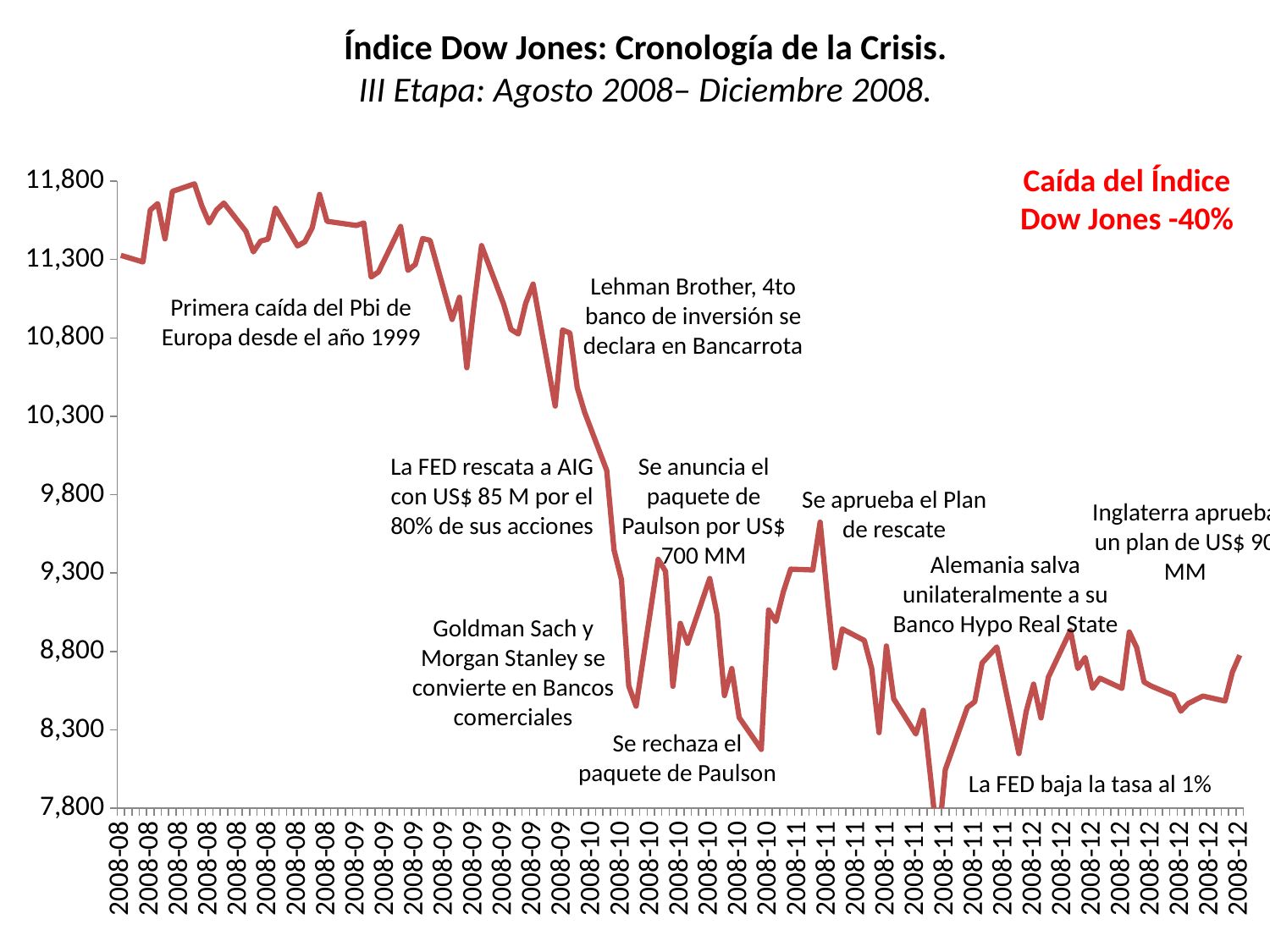
What kind of chart is shown on the slide? line chart In which month does the line reach its highest values? 2008-08 Is the value at the peak labelled 'Se aprueba el Plan de rescate' in 2008-11 greater or less than 9,300? greater Is the final value of the line in 2008-12 greater or less than 9,300? less Overall, do the values of the Dow Jones index rise or fall from 2008-08 to 2008-12? fall Is the final value of the line in 2008-12 greater or less than 8,300? greater In which month does the line reach its lowest point? 2008-11 According to the red annotation, by what percentage did the Dow Jones index fall over the period shown? -40% What is the title of the chart? Índice Dow Jones: Cronología de la Crisis. III Etapa: Agosto 2008– Diciembre 2008. Which is higher, the index value at the start of 2008-08 or the index value at the end of 2008-12? start of 2008-08